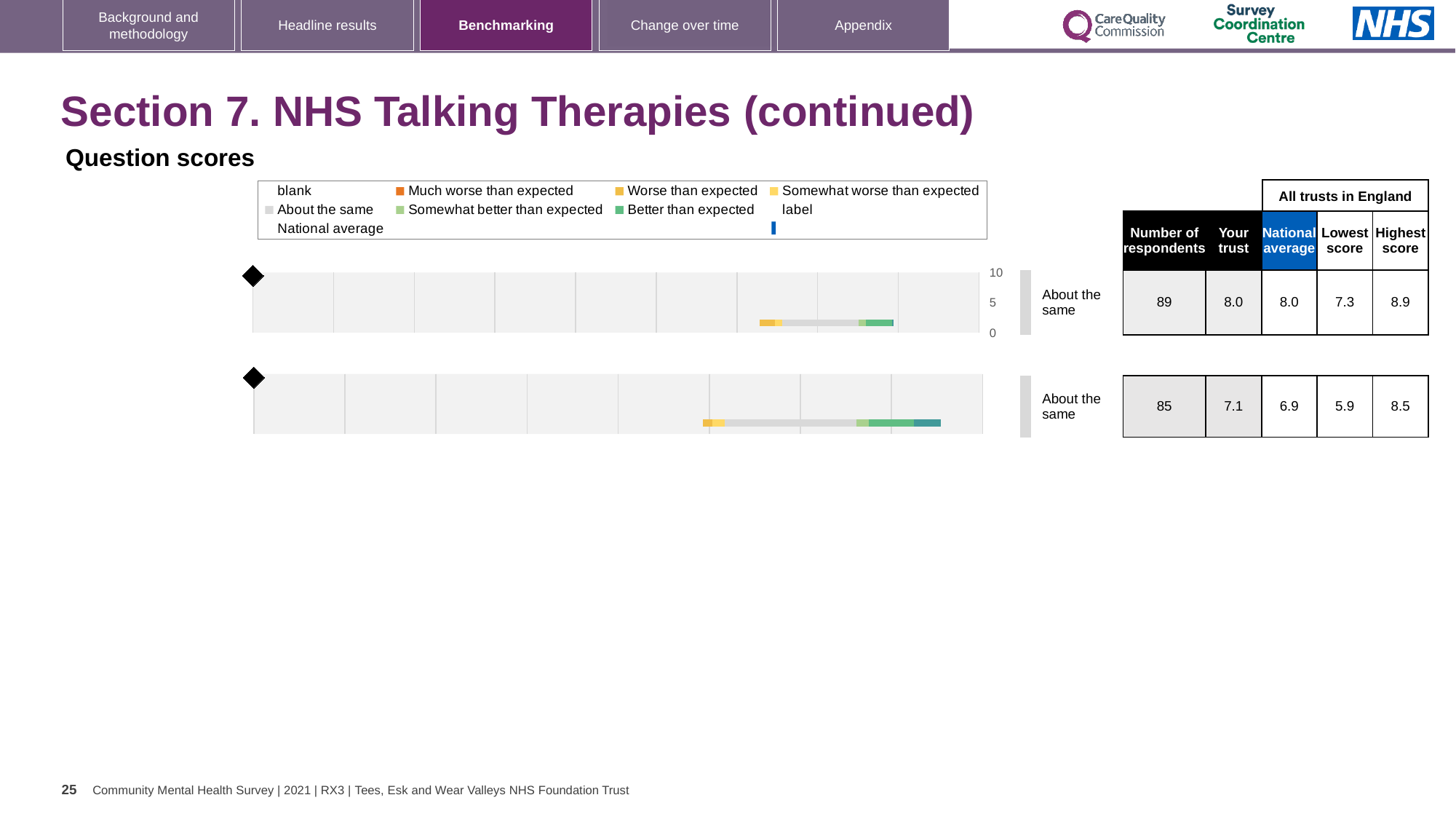
In the top chart's table, what is the difference between the Highest score and Your trust score? 0.9 In the top chart's table, what is the National average? 8.0 In the top chart's table, what is the Highest score among all trusts in England? 8.9 What is the benchmark category label shown next to both charts? About the same In the bottom chart's table, what is the difference between the Highest score and the Lowest score? 2.6 How many question rows (charts) are shown on the slide? 2 In the top chart's table, what is the score for Your trust? 8.0 In the bottom chart's table, what is the Lowest score among all trusts in England? 5.9 In the bottom chart's table, which is larger: Your trust score or the National average? Your trust In the top chart's table, what is the number of respondents? 89 What kind of chart is used for the question scores on the slide? bar chart In the bottom chart's table, what is the score for Your trust? 7.1